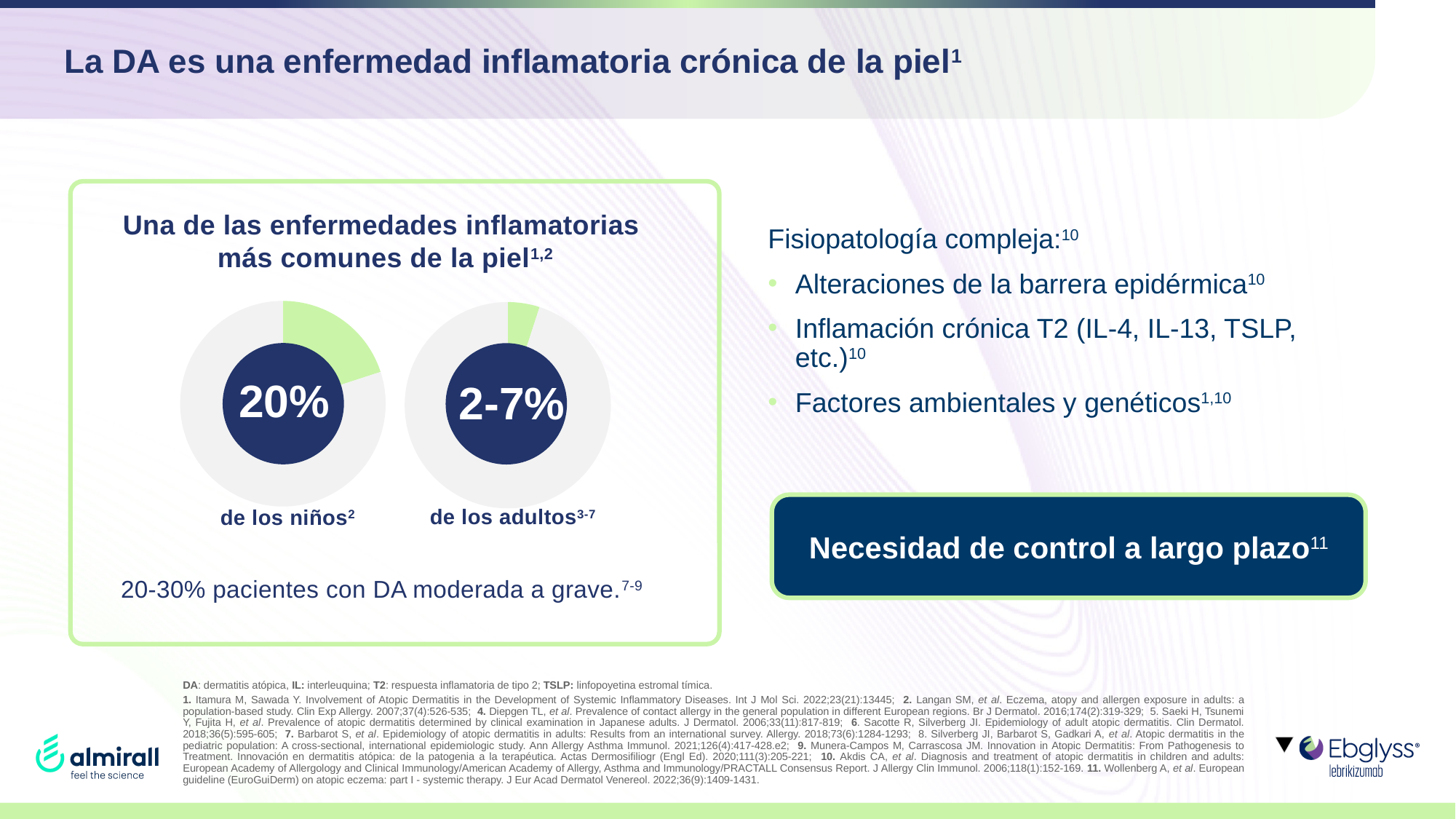
Which donut chart shows the lowest value, the one for niños or the one for adultos? adultos What label appears below the right donut chart? de los adultos What kind of chart is used to show the 20% and 2-7% figures? Donut (pie) chart What is the heading above the two donut charts? Una de las enfermedades inflamatorias más comunes de la piel How many donut charts are shown on the slide? 2 Is the value shown in the 'de los niños' donut chart greater or less than 10%? greater Which donut chart shows the highest value, the one for niños or the one for adultos? niños Which group has the higher prevalence shown in the donut charts, niños or adultos? niños What value is shown in the centre of the right donut chart, labelled 'de los adultos'? 2-7% Is the value shown in the 'de los adultos' donut chart greater or less than 10%? less What value is shown in the centre of the left donut chart, labelled 'de los niños'? 20% What colour is the highlighted slice in the donut charts? Green